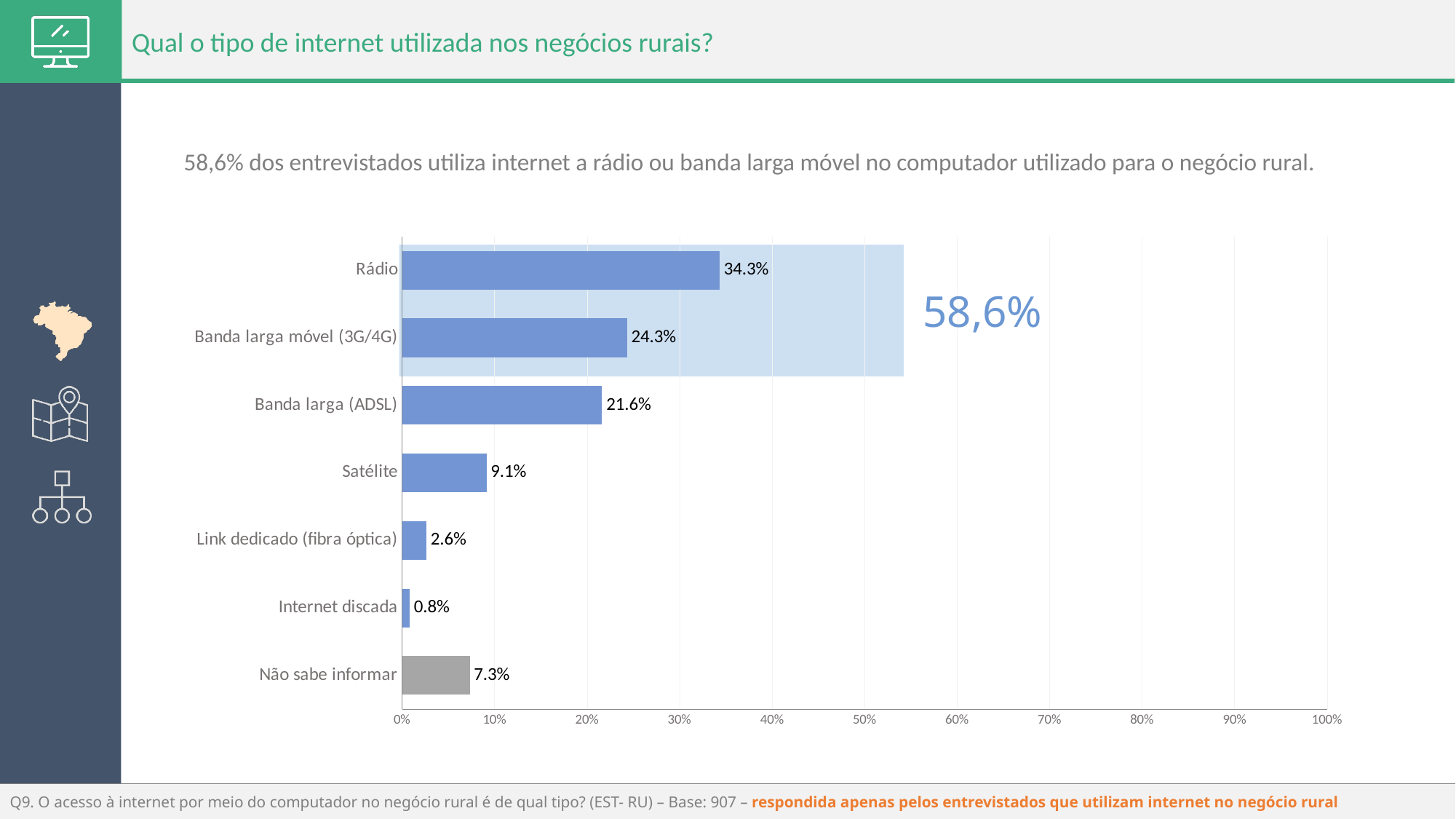
What is the combined value for Rádio and Banda larga móvel (3G/4G) highlighted on the chart? 58,6% What is the value for Rádio? 34.3% What is the value for Internet discada? 0.8% Which is larger, the value for Satélite or the value for Não sabe informar? Satélite How many categories are shown in the chart? 7 What is the difference between the values for Rádio and Banda larga (ADSL)? 12.7% What is the value for Satélite? 9.1% What is the value for Banda larga móvel (3G/4G)? 24.3% Which category has the lowest value? Internet discada Which category's bar is coloured grey instead of blue? Não sabe informar What kind of chart is shown on the slide? Bar chart Which category has the highest value? Rádio